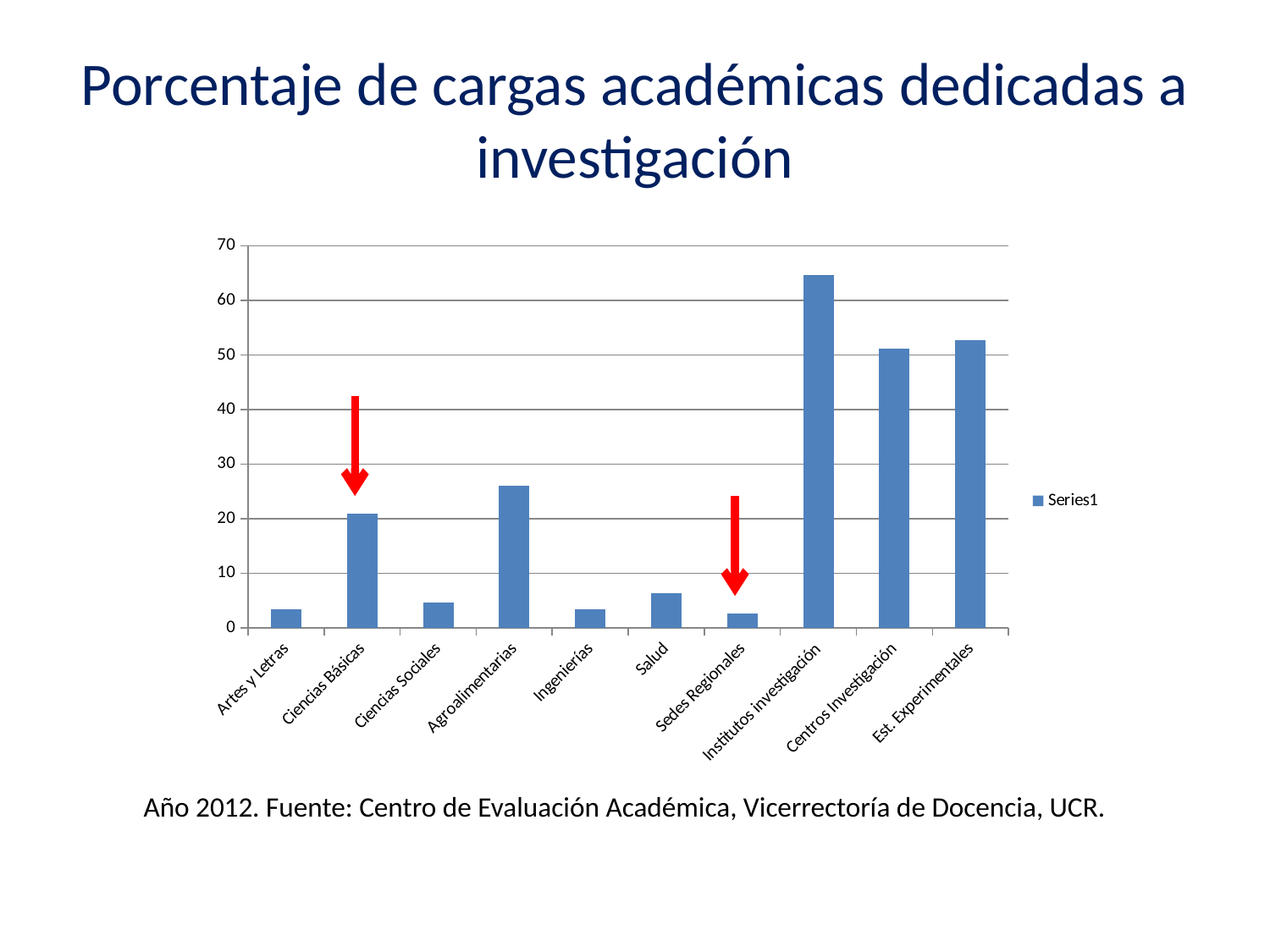
Is the value for Institutos investigación greater or less than 60? greater What is the title of the chart on the slide? Porcentaje de cargas académicas dedicadas a investigación Which is larger, the value for Agroalimentarias or the value for Salud? Agroalimentarias Which category has the highest value in the chart? Institutos investigación How many categories are plotted on the x axis of the chart? 10 Which is larger, the value for Institutos investigación or the value for Centros Investigación? Institutos investigación What kind of chart is shown on the slide? Bar chart How many series does the chart legend list? 1 Is the value for Sedes Regionales greater or less than 10? less Is the value for Agroalimentarias greater or less than 30? less